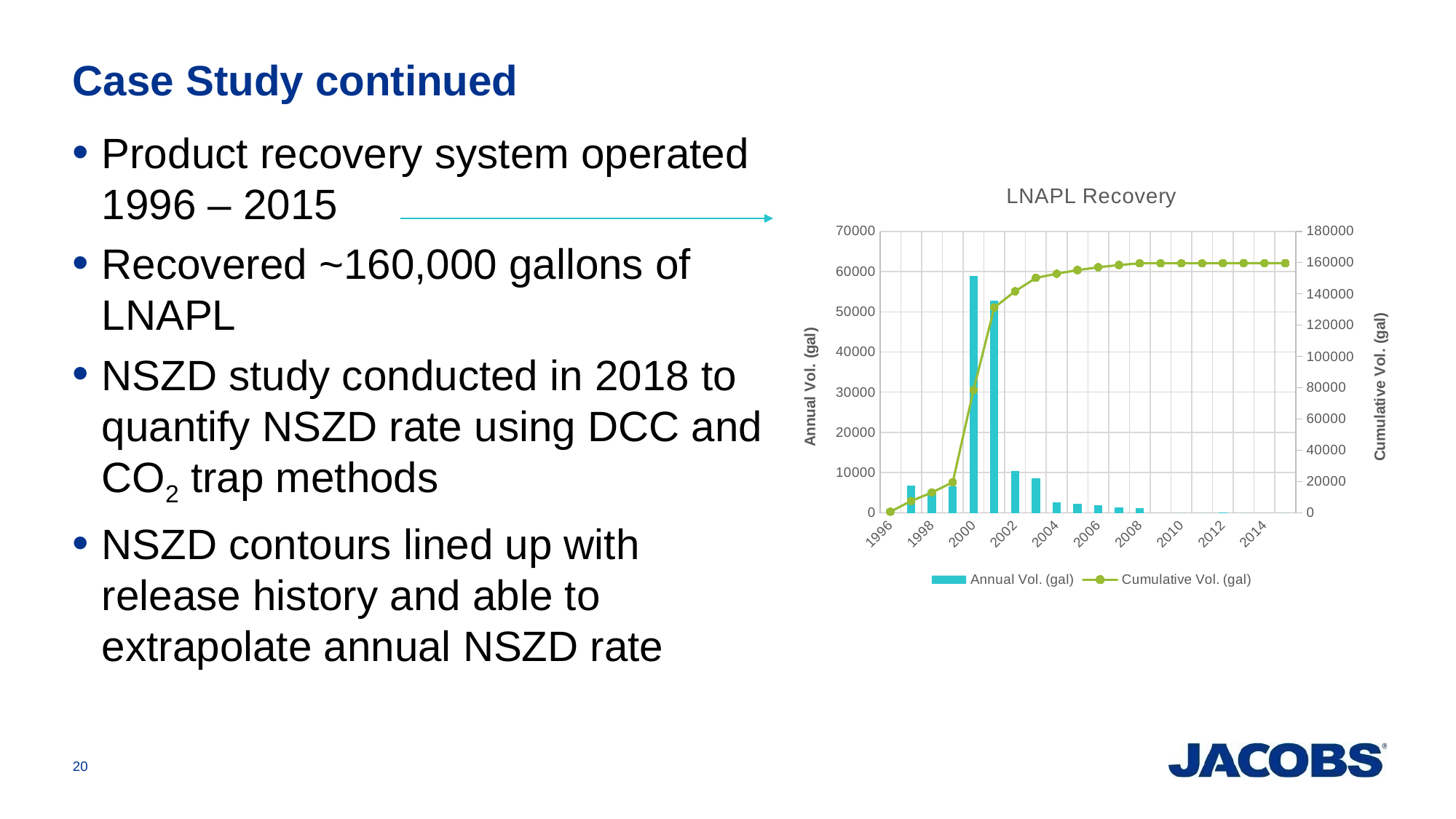
What is the title of the chart? LNAPL Recovery How many series does the chart legend list? 2 Is the Cumulative Vol. (gal) at 2014 greater or less than 140000? greater Which year has the larger Annual Vol. (gal), 2000 or 2002? 2000 Is the Annual Vol. (gal) for 2002 greater or less than 20000? less What is the label of the right-hand vertical axis? Cumulative Vol. (gal) Is the Annual Vol. (gal) for 2000 greater or less than 50000? greater Does the Cumulative Vol. (gal) line rise or fall from 1996 to 2015? rise Which year has the highest Annual Vol. (gal) bar? 2000 What kind of chart is used to show the Annual Vol. (gal) series? bar chart